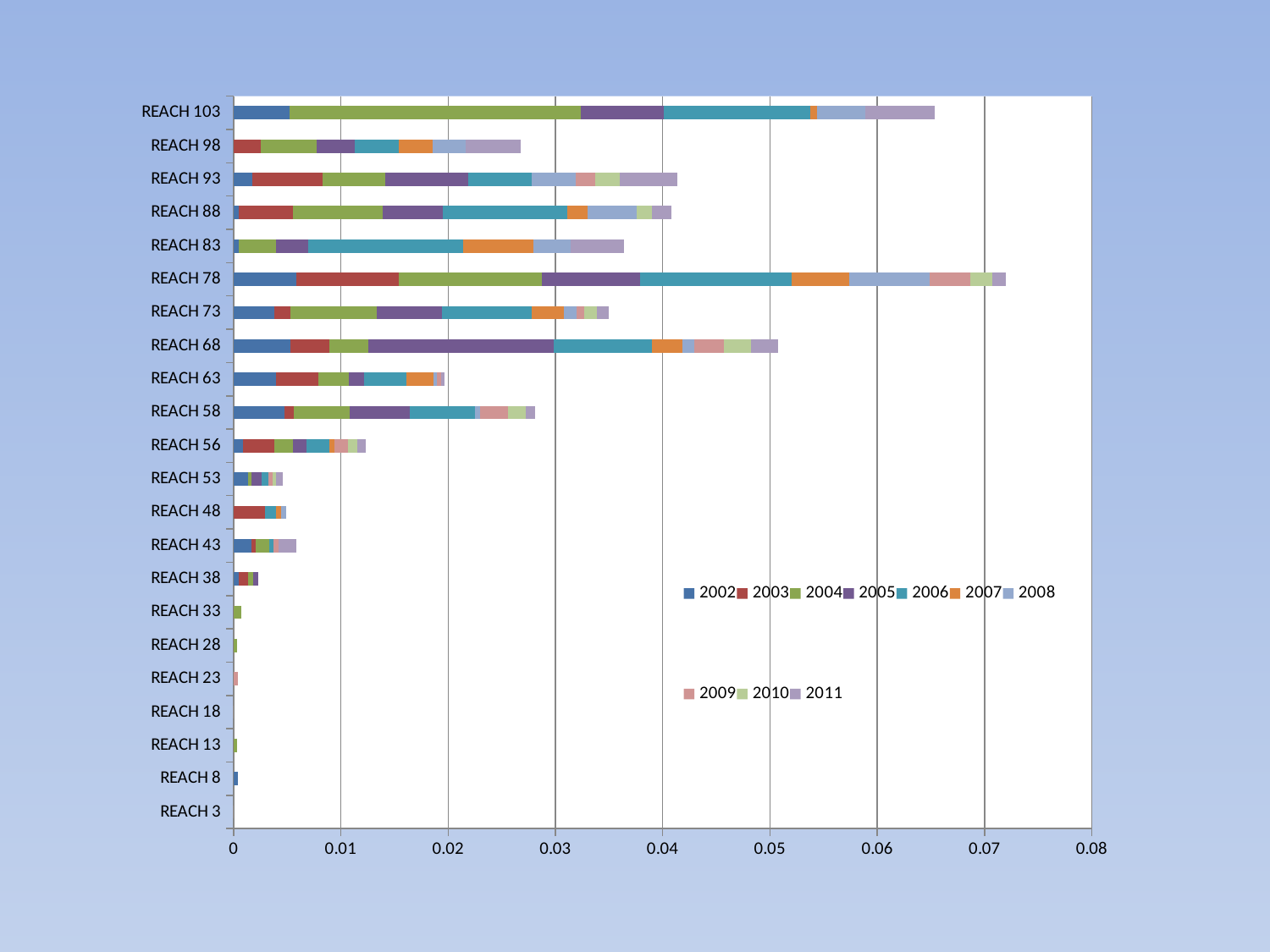
How many REACH categories are plotted on the vertical axis? 22 Which year is the first entry in the legend? 2002 Which has the larger total bar, REACH 78 or REACH 103? REACH 78 Which has the larger total bar, REACH 68 or REACH 73? REACH 68 Is the total bar for REACH 103 greater or less than 0.06? greater What is the maximum value shown on the horizontal axis? 0.08 Which REACH category has the largest total bar? REACH 78 What kind of chart is shown on the slide? Stacked bar chart How many series does the legend list? 10 Is the total bar for REACH 68 greater or less than 0.04? greater Which has the larger total bar, REACH 58 or REACH 63? REACH 58 Is the total bar for REACH 56 greater or less than 0.02? less